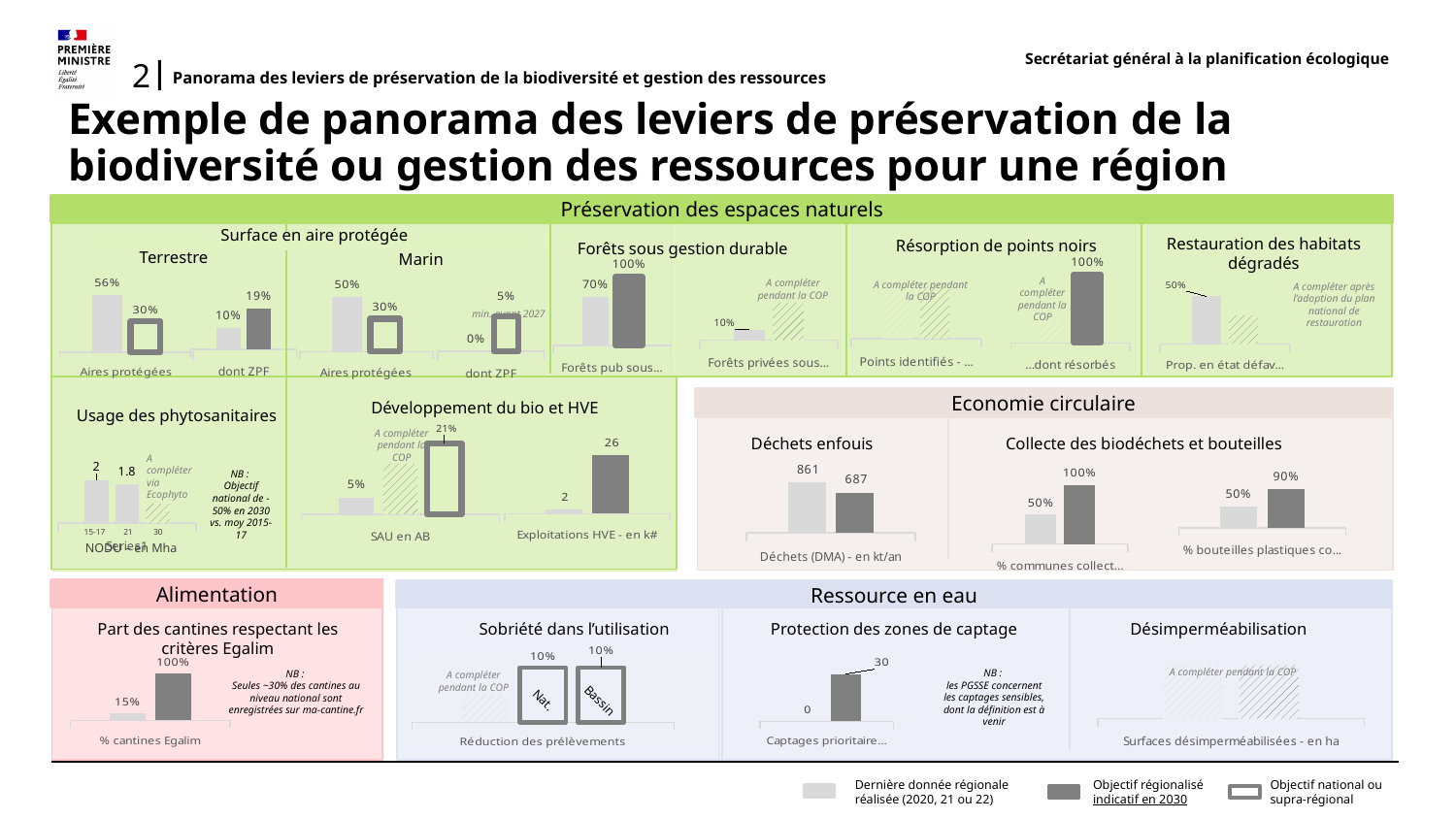
According to the legend at the bottom of the slide, what does the light grey bar represent? Dernière donnée régionale réalisée (2020, 21 ou 22) In the 'Déchets enfouis' chart, what is the value of the last regional data (light grey bar) for Déchets (DMA) - en kt/an? 861 In the 'Surface en aire protégée - Terrestre' chart, what is the last regional data value for Aires protégées? 56% In the 'Protection des zones de captage' chart, what is the 2030 objective for Captages prioritaires? 30 In the 'Collecte des biodéchets et bouteilles' chart, which is larger: the 2030 objective for % communes collect... or the 2030 objective for % bouteilles plastiques co...? % communes collect... In the 'Déchets enfouis' chart, what is the difference between the last regional data and the 2030 objective for Déchets (DMA)? 174 In the 'Déchets enfouis' chart, what is the 2030 regional objective (dark grey bar) for Déchets (DMA) - en kt/an? 687 In the 'Développement du bio et HVE' chart, what is the 2030 objective for Exploitations HVE - en k#? 26 In the 'Surface en aire protégée - Marin' chart, what is the last regional data value for 'dont ZPF'? 0% In the 'Part des cantines respectant les critères Egalim' chart, what is the last regional data value for % cantines Egalim? 15% In the 'Surface en aire protégée - Terrestre' chart, what is the 2030 objective for 'dont ZPF'? 19% In the 'Développement du bio et HVE' chart, what is the last regional data value for SAU en AB? 5%